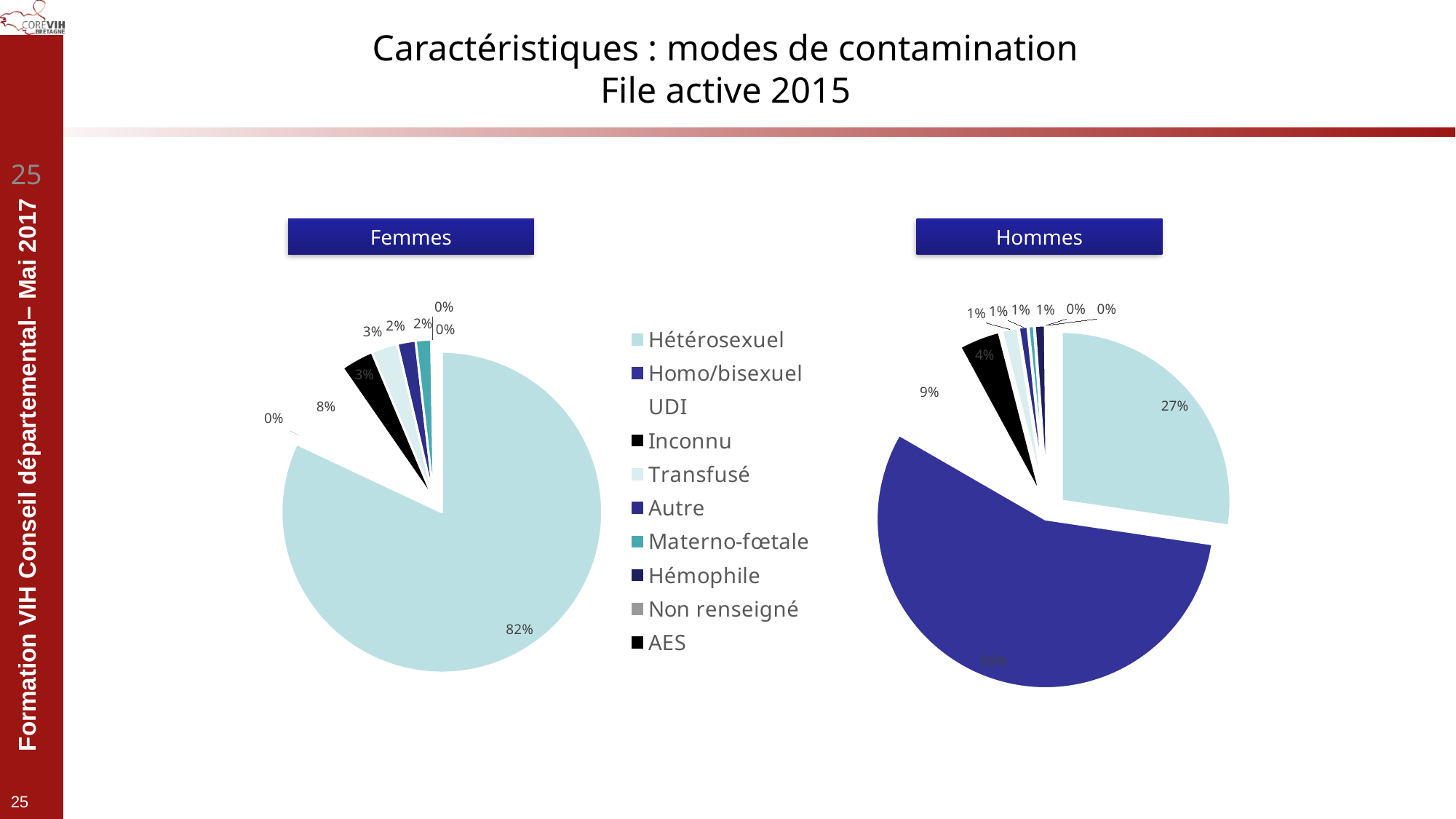
In the Hommes pie chart, which category has the largest slice? Homo/bisexuel What is the difference in percentage points between the Hétérosexuel share in the Femmes pie chart (82%) and in the Hommes pie chart (27%)? 55 In the Femmes pie chart, which category has the largest slice? Hétérosexuel How many entries does the shared legend list? 10 In the Femmes pie chart, what share is Hétérosexuel? 82% In the Hommes pie chart, what share is Homo/bisexuel? 56% In the Femmes pie chart, what share is Inconnu? 3% In the Hommes pie chart, what share is Inconnu? 4% Which is larger: the Hétérosexuel share in the Femmes pie chart or in the Hommes pie chart? Femmes What kind of chart is used for the Femmes data? pie chart In the Hommes pie chart, what share is Hétérosexuel? 27% What are the titles of the two pie charts on the slide? Femmes and Hommes